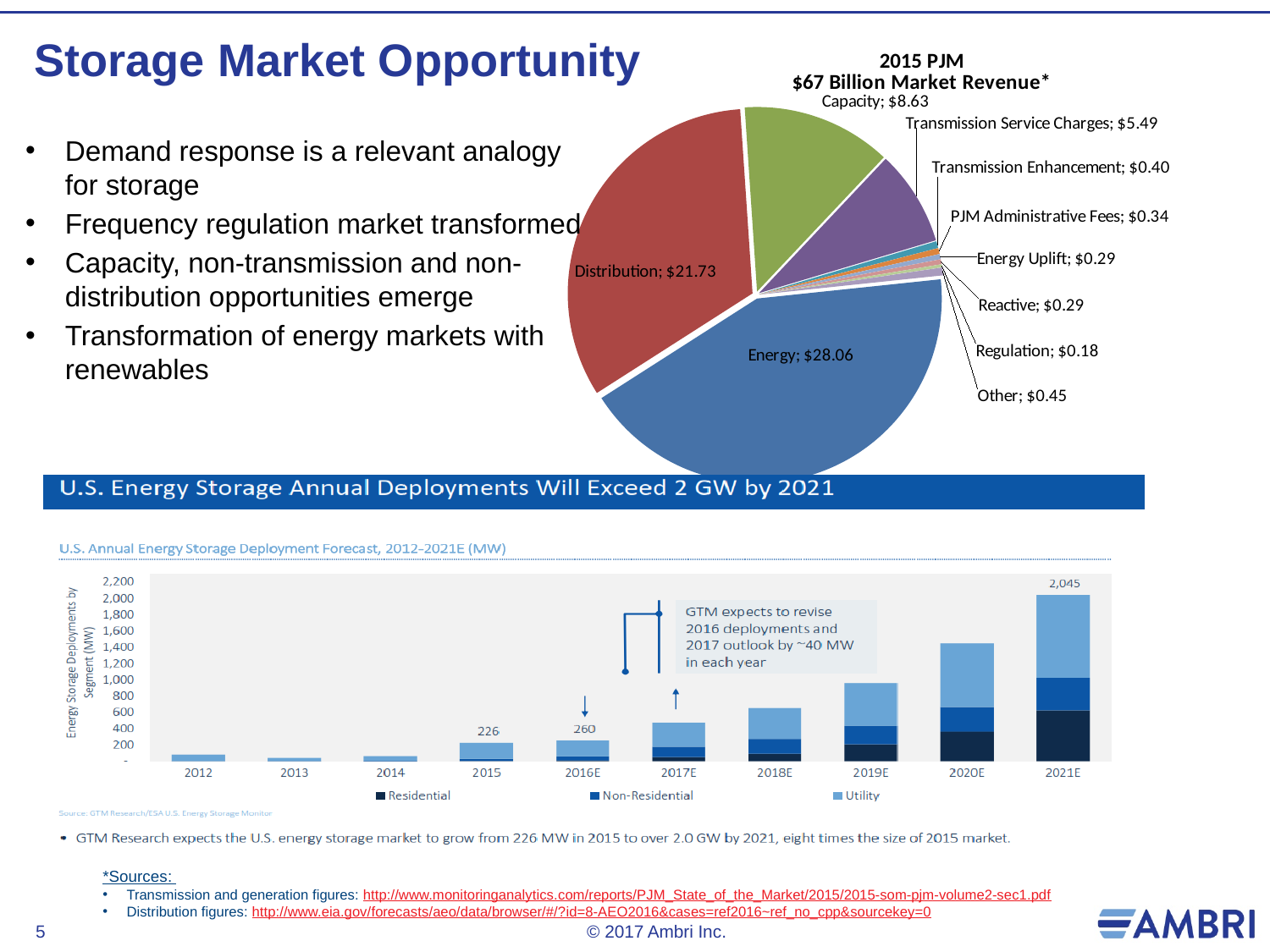
How many series does the legend of the 'U.S. Annual Energy Storage Deployment Forecast' bar chart list? 3 In the pie chart titled '2015 PJM $67 Billion Market Revenue', how many slices are there? 10 In the pie chart titled '2015 PJM $67 Billion Market Revenue', what is the value for Distribution? $21.73 In the pie chart titled '2015 PJM $67 Billion Market Revenue', which slice is the largest? Energy In the 'U.S. Annual Energy Storage Deployment Forecast' bar chart, is the total for 2020E greater or less than 1,200? greater In the pie chart titled '2015 PJM $67 Billion Market Revenue', which is larger: Capacity or Transmission Service Charges? Capacity In the pie chart titled '2015 PJM $67 Billion Market Revenue', what is the difference between the Energy and Distribution values? $6.33 In the pie chart titled '2015 PJM $67 Billion Market Revenue', what is the value for Energy? $28.06 In the 'U.S. Annual Energy Storage Deployment Forecast' bar chart, what is the labeled value for 2015? 226 In the 'U.S. Annual Energy Storage Deployment Forecast' bar chart, what is the labeled total for 2021E? 2,045 How many years are shown on the x axis of the 'U.S. Annual Energy Storage Deployment Forecast' bar chart? 10 What kind of chart is the 'U.S. Annual Energy Storage Deployment Forecast, 2012-2021E (MW)' chart? Stacked bar chart